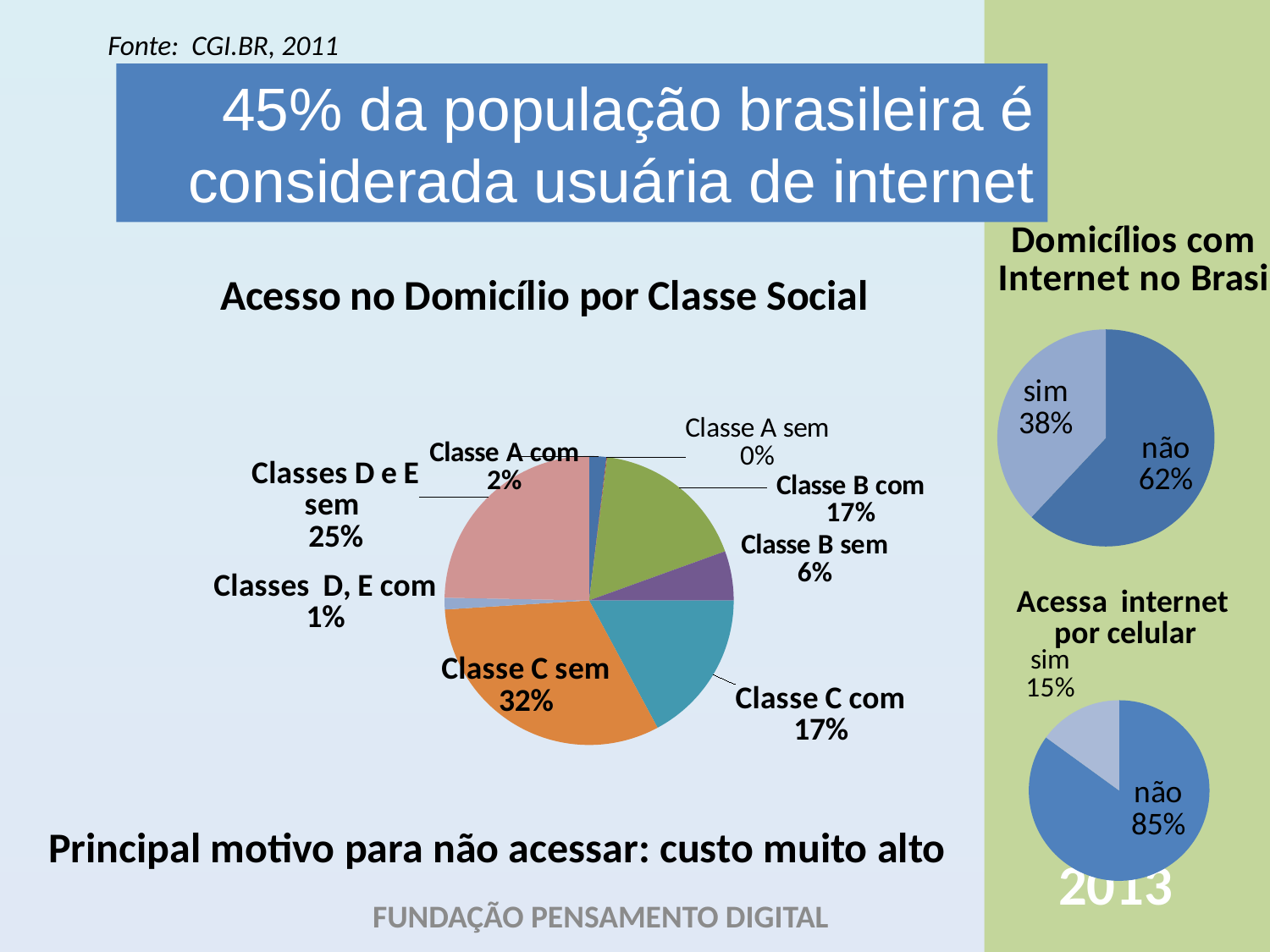
In the chart 'Acesso no Domicílio por Classe Social', what is the difference between Classe C sem and Classes D e E sem? 7 percentage points In the chart 'Acessa internet por celular', what is the difference between 'não' and 'sim'? 70 percentage points In the chart 'Acesso no Domicílio por Classe Social', what is the value for Classe C sem? 32% In the chart 'Acessa internet por celular', what is the value for 'não'? 85% How many categories are shown in the chart 'Acesso no Domicílio por Classe Social'? 8 In the chart 'Domicílios com Internet no Brasil', what is the value for 'sim'? 38% In the chart 'Acesso no Domicílio por Classe Social', which category has the smallest share? Classe A sem In the chart 'Acesso no Domicílio por Classe Social', which category has the largest share? Classe C sem What kind of chart is 'Acesso no Domicílio por Classe Social'? Pie chart In the chart 'Acesso no Domicílio por Classe Social', what is the value for Classe B sem? 6% In the chart 'Acesso no Domicílio por Classe Social', what is the value for Classes D e E sem? 25% In the chart 'Acesso no Domicílio por Classe Social', which is larger: Classe B com or Classe B sem? Classe B com